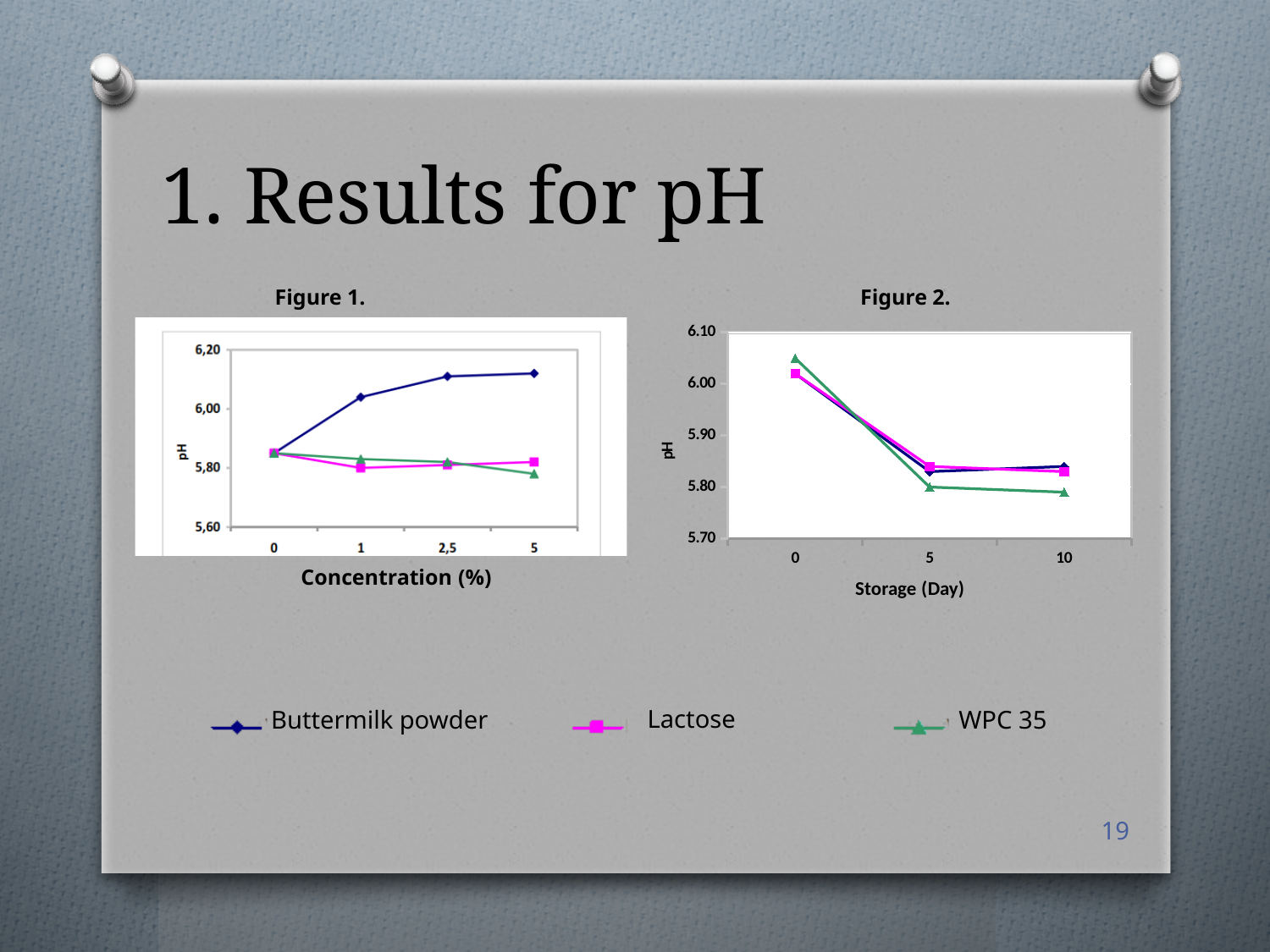
In Figure 2, is the pH for WPC 35 at day 0 greater or less than 6.00? greater In Figure 1, is the pH for Buttermilk powder at 5% concentration greater or less than 6,00? greater In Figure 2, which series has the lowest pH at day 10? WPC 35 In Figure 2, how many storage day values are plotted along the x axis? 3 What kind of chart is Figure 1? line chart In Figure 2, is the pH for Buttermilk powder at day 5 greater or less than 5.90? less In Figure 1, how many concentration values are plotted along the x axis? 4 In Figure 1, does the pH for Buttermilk powder rise or fall as concentration increases? rise In Figure 2, does the pH for WPC 35 rise or fall as storage days increase? fall What kind of chart is Figure 2? line chart In Figure 1, which series has the highest pH at 5% concentration? Buttermilk powder How many series does the legend list for the charts? 3